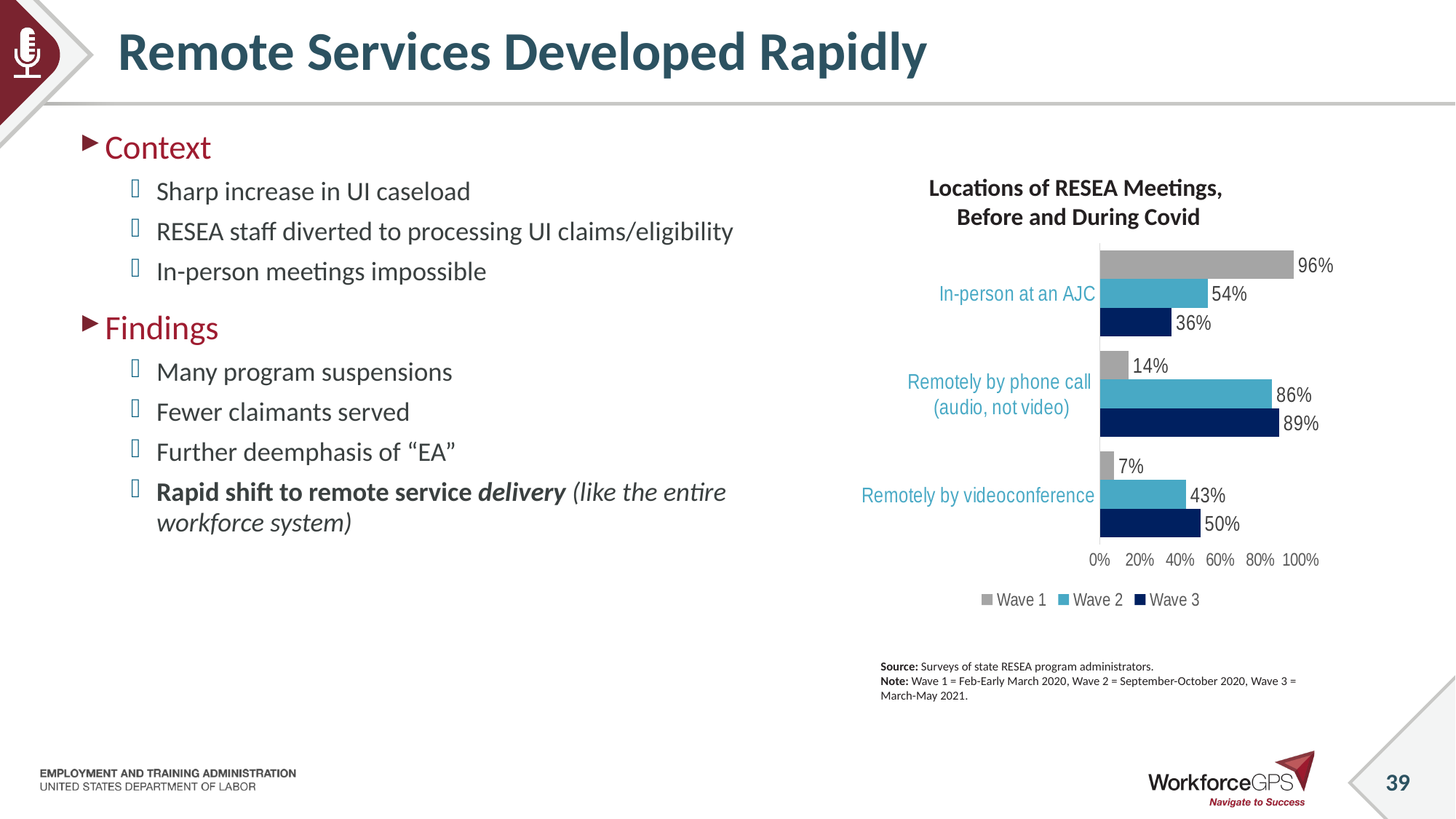
What kind of chart is shown on the slide? Bar chart What is the Wave 1 value for In-person at an AJC? 96% What is the title of the chart? Locations of RESEA Meetings, Before and During Covid How many series does the legend list? 3 How many categories are shown on the chart? 3 Which is larger for Remotely by videoconference: the Wave 2 value or the Wave 3 value? Wave 3 What is the Wave 2 value for Remotely by videoconference? 43% What is the difference between the Wave 1 and Wave 3 values for In-person at an AJC? 60% Which category has the lowest Wave 3 value? In-person at an AJC What is the Wave 3 value for Remotely by phone call (audio, not video)? 89% Which series is shown in gray in the legend? Wave 1 Which category has the highest Wave 1 value? In-person at an AJC